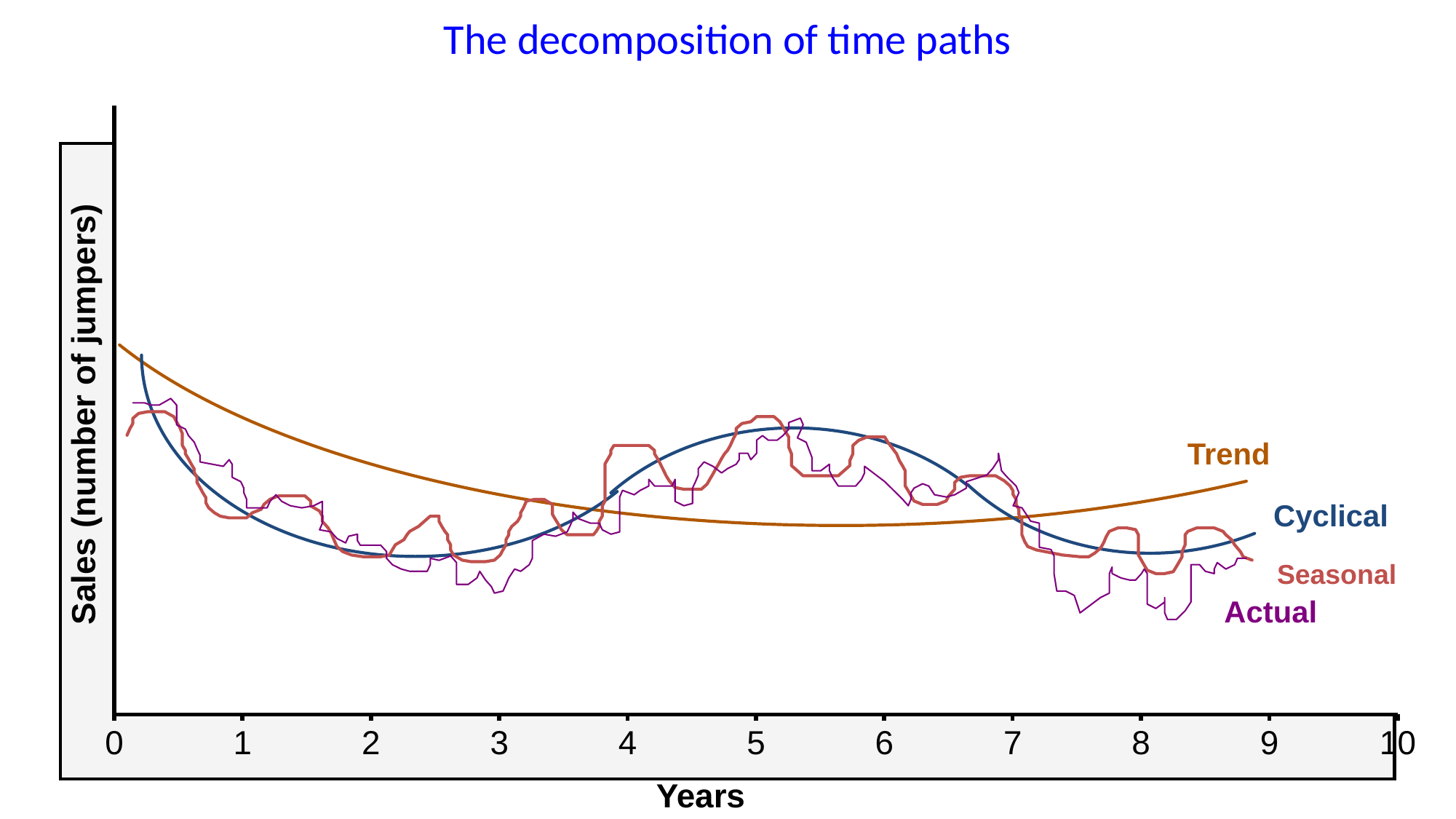
Does the Trend line rise or fall between year 7 and year 9? rise At year 2, which is higher: the Trend line or the Cyclical line? Trend At year 5, which is higher: the Cyclical line or the Trend line? Cyclical Does the Trend line rise or fall between year 0 and year 5? fall Does the Cyclical line rise or fall between year 5 and year 7? fall What is the title of the chart? The decomposition of time paths What kind of chart is shown on the slide? line chart At year 8, which is higher: the Cyclical line or the Actual line? Cyclical How many series are labelled on the chart? 4 What is the label on the vertical axis of the chart? Sales (number of jumpers)